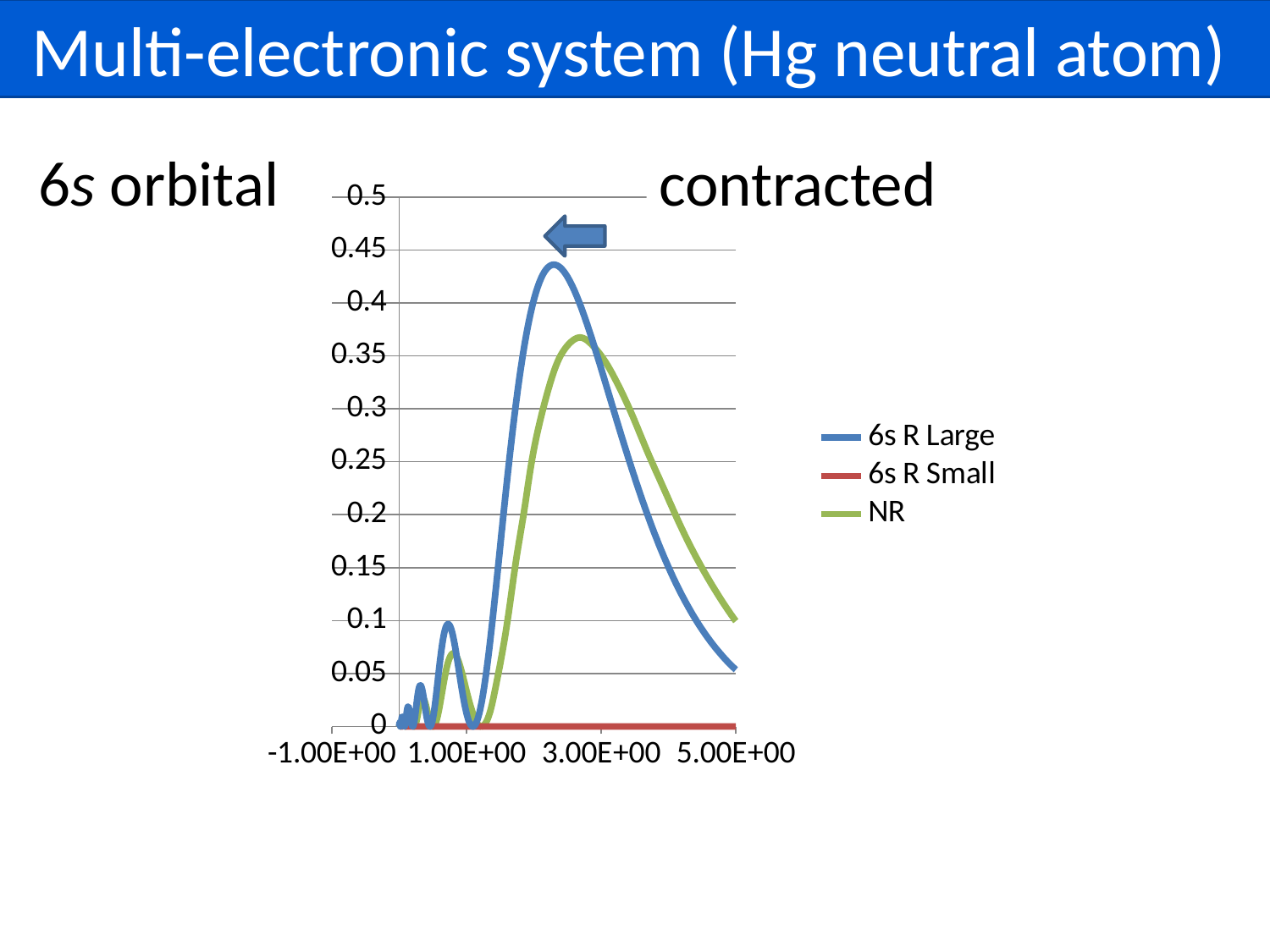
Which series are listed in the chart legend? 6s R Large, 6s R Small, NR What colour is the line for the NR series? green Is the peak value of the 6s R Large series greater or less than 0.4? greater How many series does the legend list? 3 What kind of chart is shown on the slide? line chart Is the peak value of the NR series greater or less than 0.35? greater Which series stays at 0 across the whole x-axis range? 6s R Small Is the value of the 6s R Large series at 5.00E+00 greater or less than 0.1? less After its main peak, does the 6s R Large series rise or fall as x increases toward 5.00E+00? fall Which series reaches the highest peak value, 6s R Large or NR? 6s R Large